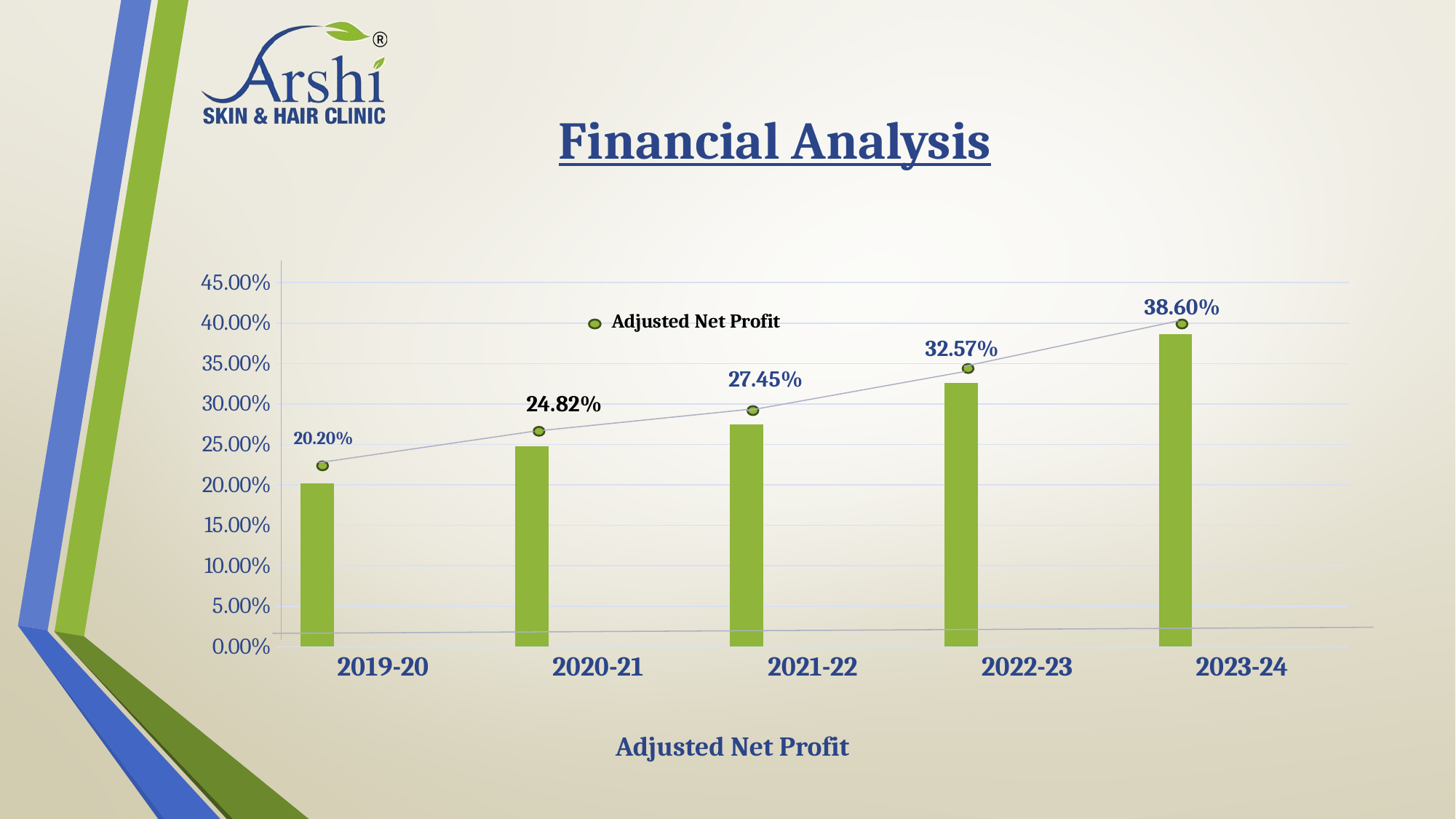
What is the title of the slide containing the chart? Financial Analysis Does the Adjusted Net Profit rise or fall from 2019-20 to 2023-24? rise Which year has a higher Adjusted Net Profit, 2020-21 or 2022-23? 2022-23 Which year has the highest Adjusted Net Profit? 2023-24 What is the Adjusted Net Profit for 2019-20? 20.20% What is the difference in Adjusted Net Profit between 2020-21 and 2019-20? 4.62% Is the Adjusted Net Profit for 2022-23 greater or less than 30.00%? greater Which year has the lowest Adjusted Net Profit? 2019-20 How many years are shown on the x axis of the chart? 5 What is the difference in Adjusted Net Profit between 2023-24 and 2022-23? 6.03% What is the Adjusted Net Profit for 2021-22? 27.45% What is the Adjusted Net Profit for 2023-24? 38.60%